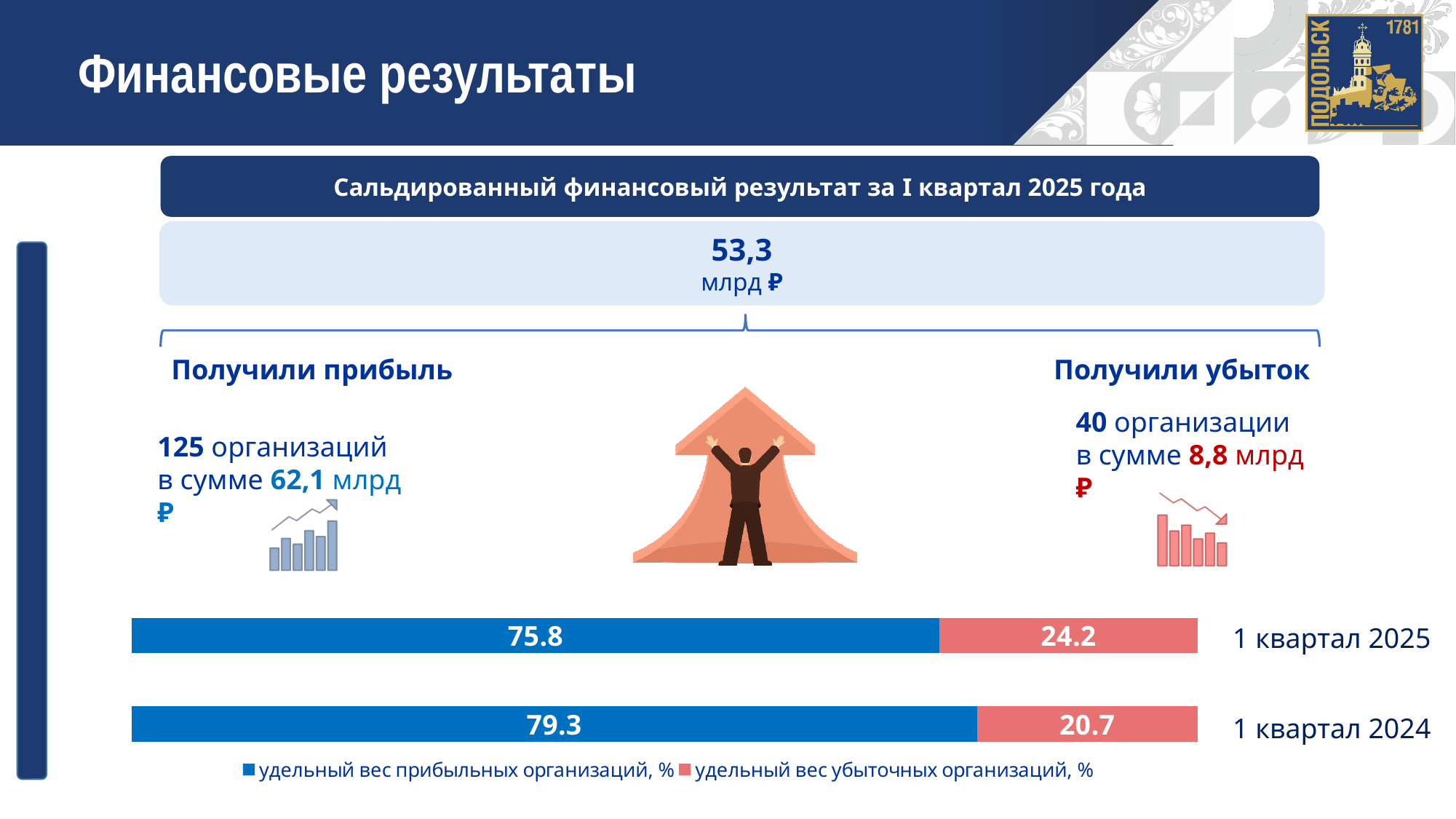
How many periods (bars) are shown in the chart? 2 What is the total of the stacked bar for 1 квартал 2025? 100 What is the difference between the share of loss-making organisations in 1 квартал 2025 and 1 квартал 2024? 3.5 What is the share of profitable organisations (удельный вес прибыльных организаций, %) for 1 квартал 2025? 75.8 What type of chart is shown at the bottom of the slide? Stacked bar chart What is the value of the red segment (удельный вес убыточных организаций, %) for 1 квартал 2025? 24.2 How many series does the chart legend list? 2 By how much did the share of profitable organisations change from 1 квартал 2024 to 1 квартал 2025? 3.5 What is the value of the blue segment (удельный вес прибыльных организаций, %) for 1 квартал 2024? 79.3 What is the share of loss-making organisations (удельный вес убыточных организаций, %) for 1 квартал 2024? 20.7 Which period has the higher share of profitable organisations, 1 квартал 2025 or 1 квартал 2024? 1 квартал 2024 Which period has the higher share of loss-making organisations? 1 квартал 2025